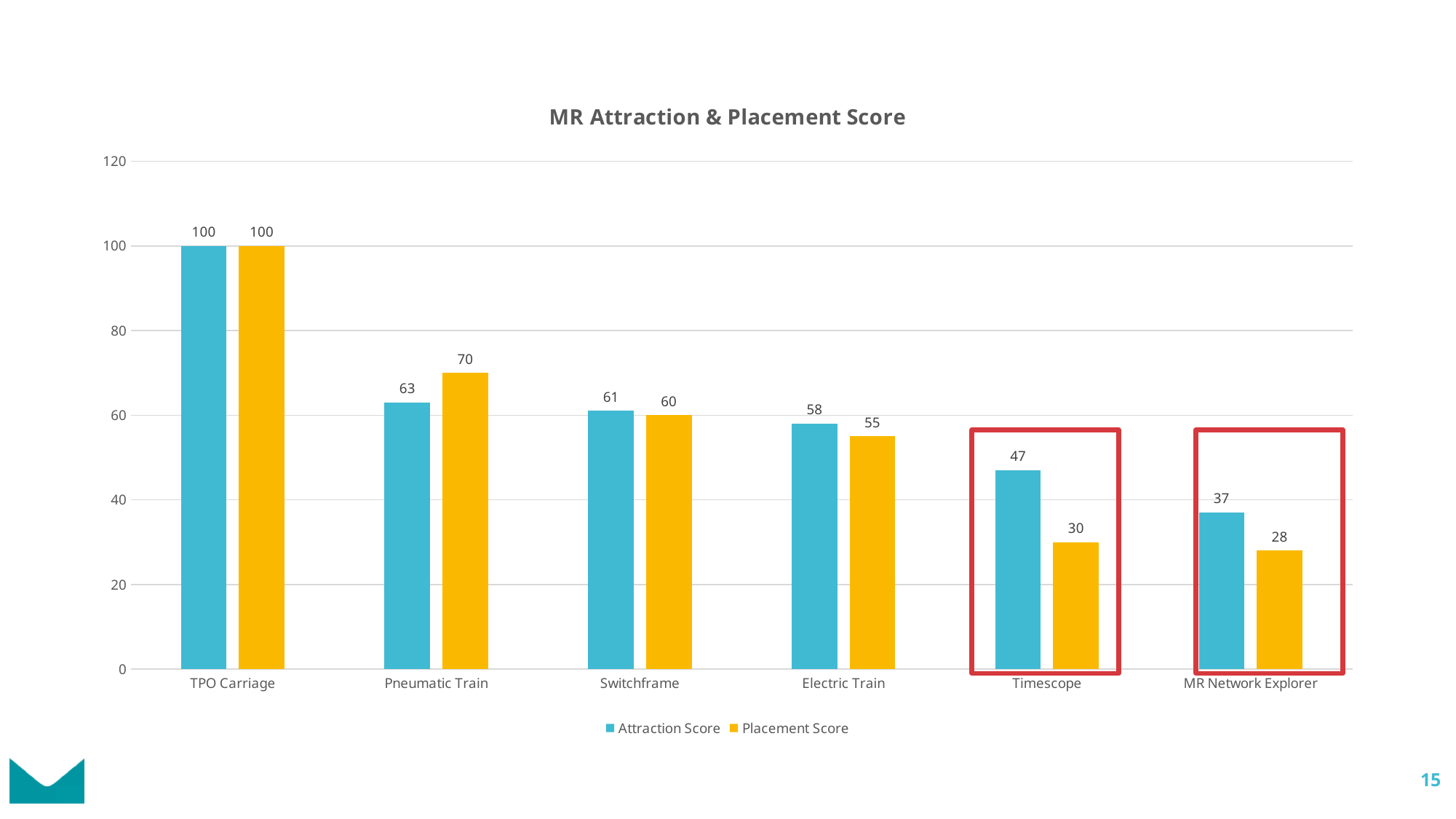
What is the Attraction Score for Pneumatic Train? 63 Which category has the highest Placement Score? TPO Carriage What is the Placement Score for Timescope? 30 Which category has the lowest Attraction Score? MR Network Explorer Which is larger for Pneumatic Train, the Attraction Score or the Placement Score? Placement Score How many series does the legend list? 2 What is the Placement Score for MR Network Explorer? 28 What kind of chart is shown on the slide? Bar chart What is the difference between the Attraction Score and the Placement Score for Timescope? 17 How many categories are shown on the x axis? 6 What is the difference between the Placement Score for Pneumatic Train and the Placement Score for Switchframe? 10 What is the title of the chart? MR Attraction & Placement Score